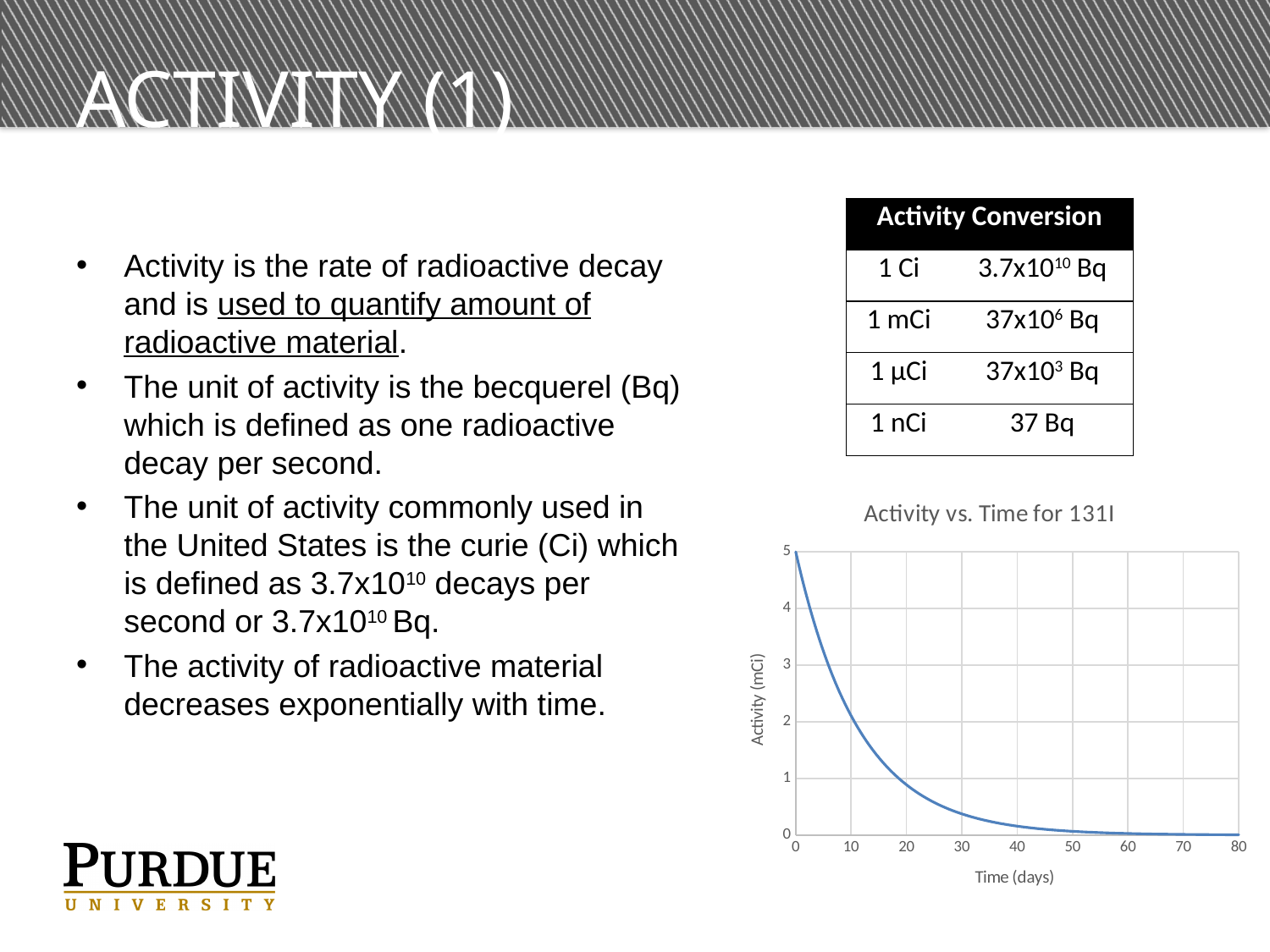
Is the activity at 60 days greater or less than 1 mCi? less What kind of chart is shown on the slide? line chart What is the activity in mCi at time 0 days? 5 Does the activity rise or fall as time increases along the x axis? fall Which is larger, the activity at 10 days or the activity at 30 days? 10 days What is the title of the chart? Activity vs. Time for 131I Is the activity at 20 days greater or less than 1 mCi? less What is the label of the y axis of the chart? Activity (mCi) Is the activity at 40 days greater or less than 1 mCi? less At what time (days) is the activity highest? 0